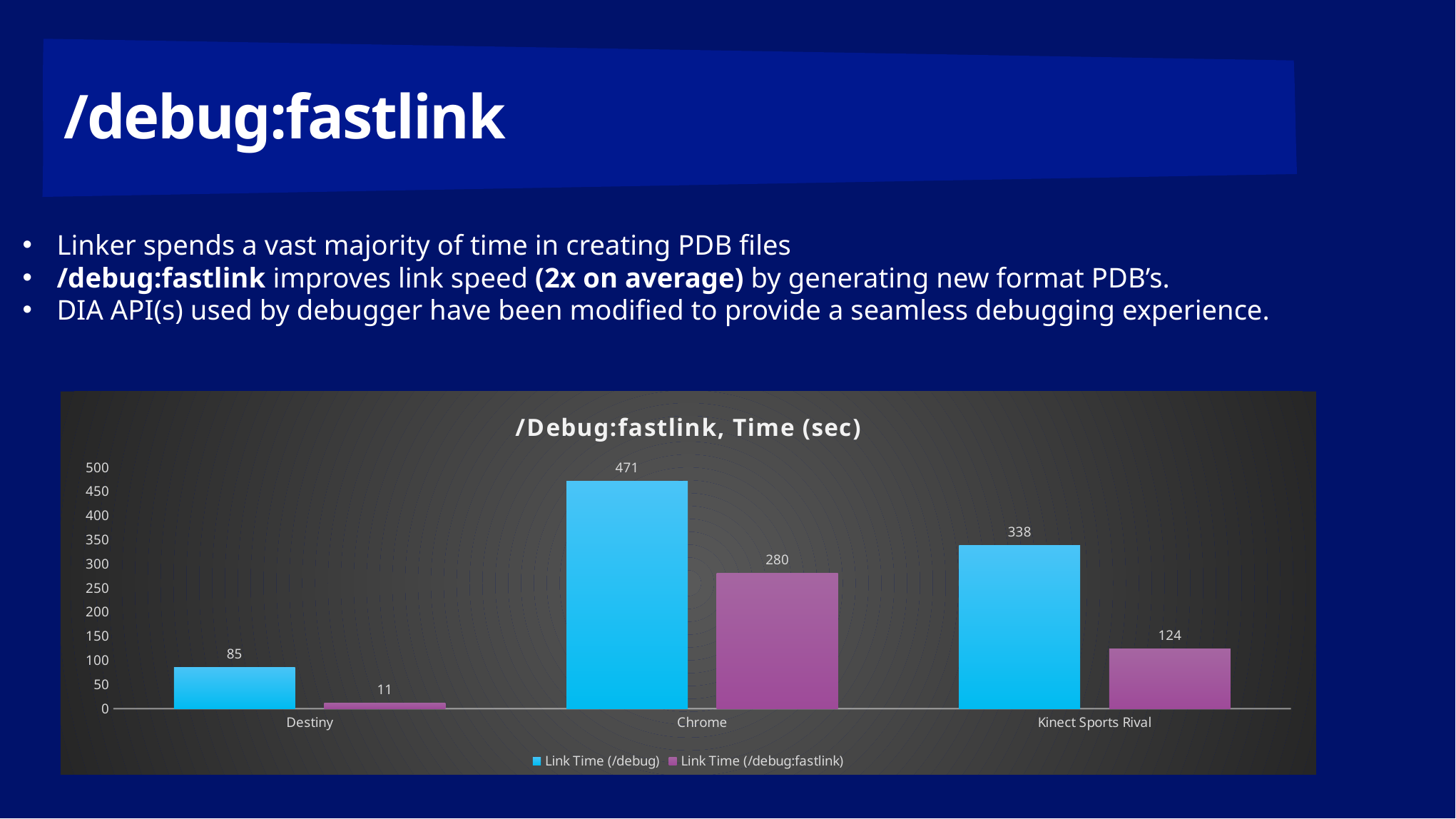
What is the Link Time (/debug:fastlink) value for Destiny? 11 Which is larger: the Link Time (/debug:fastlink) value for Chrome or the Link Time (/debug) value for Kinect Sports Rival? Link Time (/debug) for Kinect Sports Rival What is the Link Time (/debug) value for Chrome? 471 Which category has the lowest Link Time (/debug:fastlink) value? Destiny What is the Link Time (/debug:fastlink) value for Kinect Sports Rival? 124 What is the difference between the Link Time (/debug) values for Kinect Sports Rival and Destiny? 253 Which category has the highest Link Time (/debug) value? Chrome What kind of chart is shown on the slide? Bar chart What is the difference between the Link Time (/debug) and Link Time (/debug:fastlink) values for Chrome? 191 How many series does the chart legend list? 2 What is the title of the chart? /Debug:fastlink, Time (sec) How many categories are shown on the x axis of the chart? 3